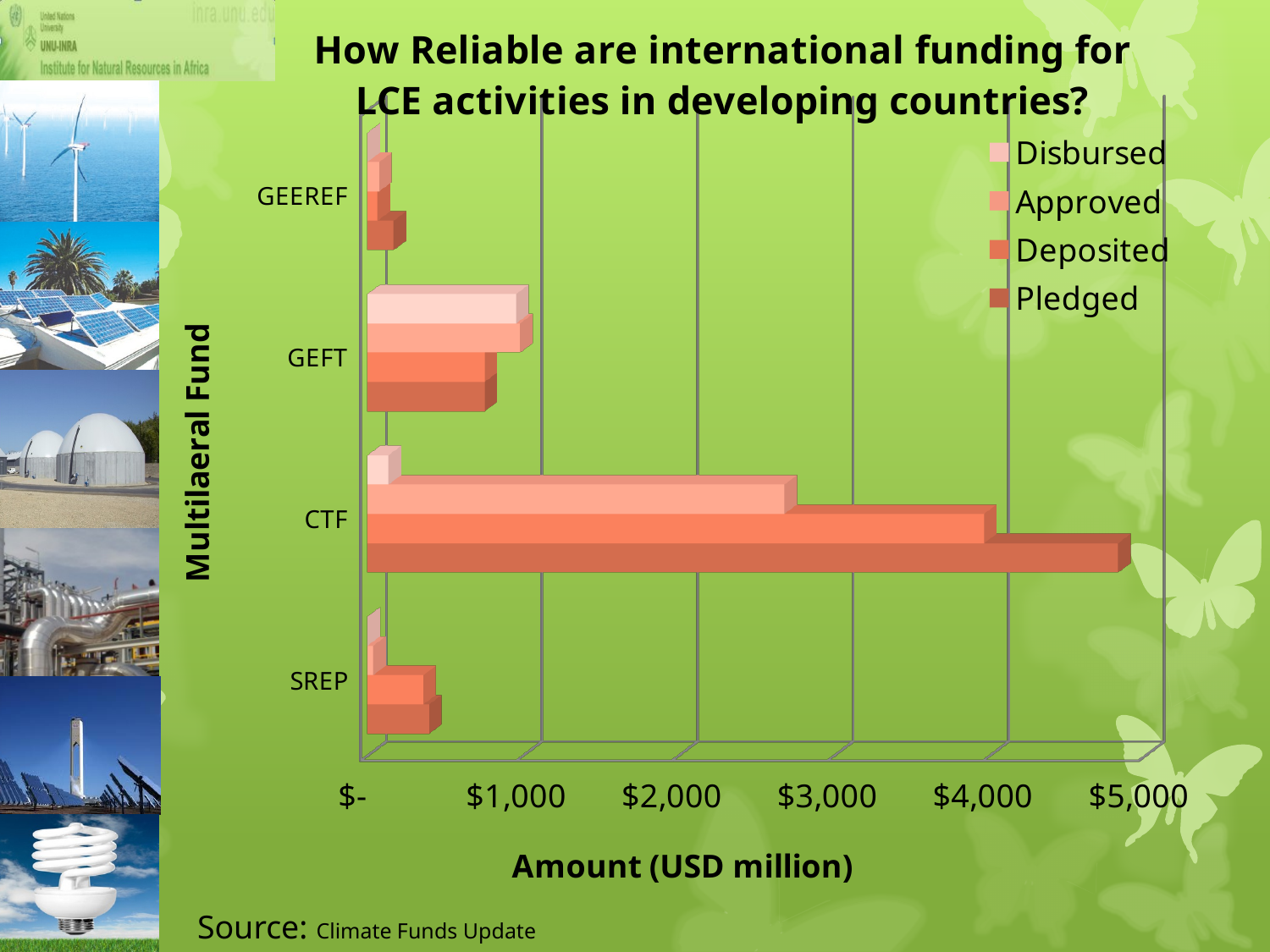
Which is larger for CTF, the Approved value or the Disbursed value? Approved What is the title of the chart's horizontal axis? Amount (USD million) Is the Pledged value for GEFT greater or less than $1,000? less How many series does the chart's legend list? 4 Is the Approved value for CTF greater or less than $2,000? greater Is the Pledged value for CTF greater or less than $4,000? greater What kind of chart is shown on the slide? bar chart Which fund has the highest Pledged amount? CTF Which is larger, the Pledged value for CTF or the Pledged value for GEFT? CTF How many multilateral funds are shown on the y axis of the chart? 4